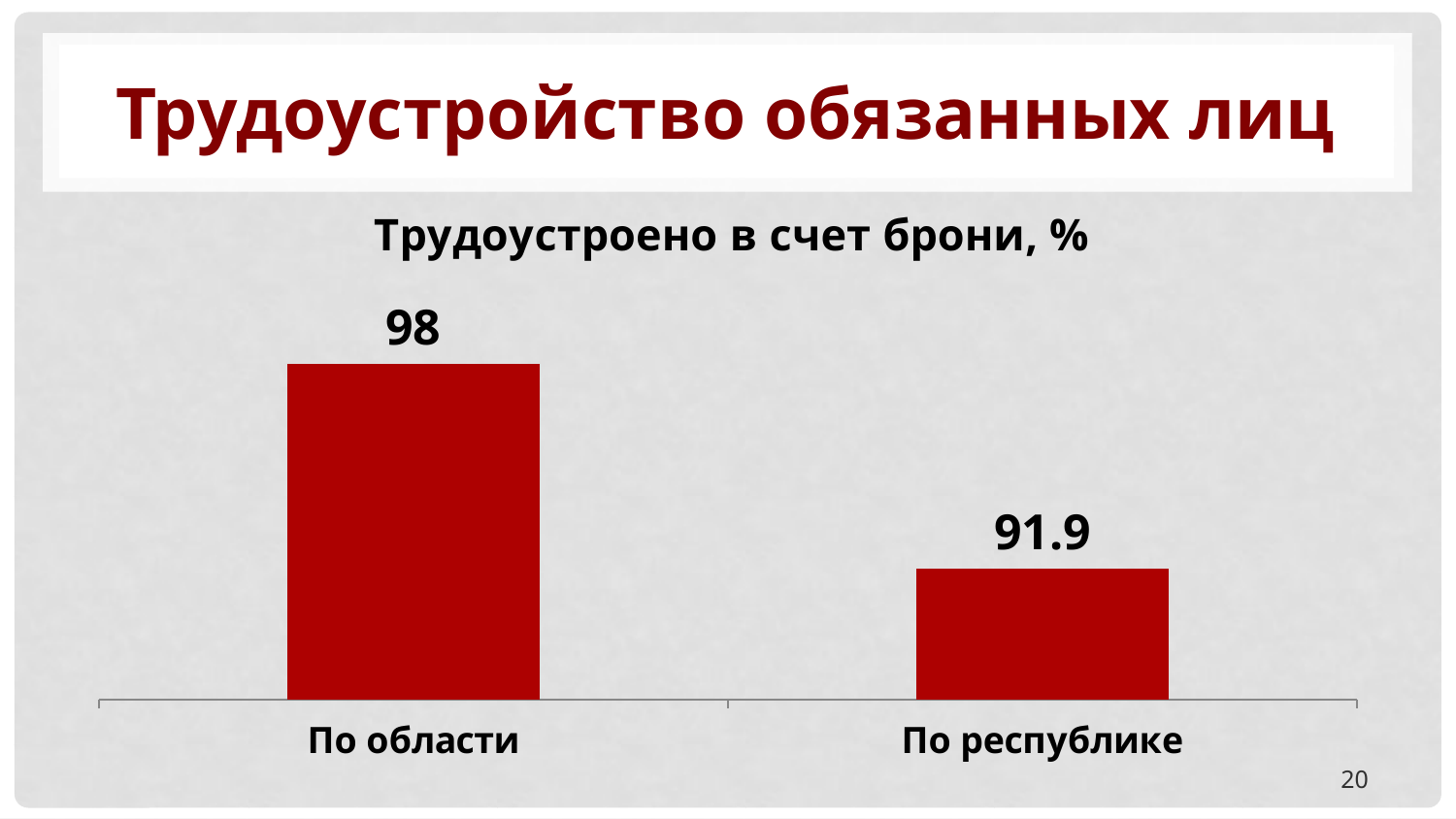
Do the values rise or fall from left to right along the x axis? Fall How many categories are shown in the chart? 2 What is the title of the chart? Трудоустроено в счет брони, % What kind of chart is shown on the slide? Bar chart What is the difference between the values for По области and По республике? 6.1 Which is larger, the value for По области or for По республике? По области What is the value for По области? 98 What colour are the bars in the chart? Dark red What is the value for По республике? 91.9 Which category has the highest value? По области Which category has the lowest value? По республике